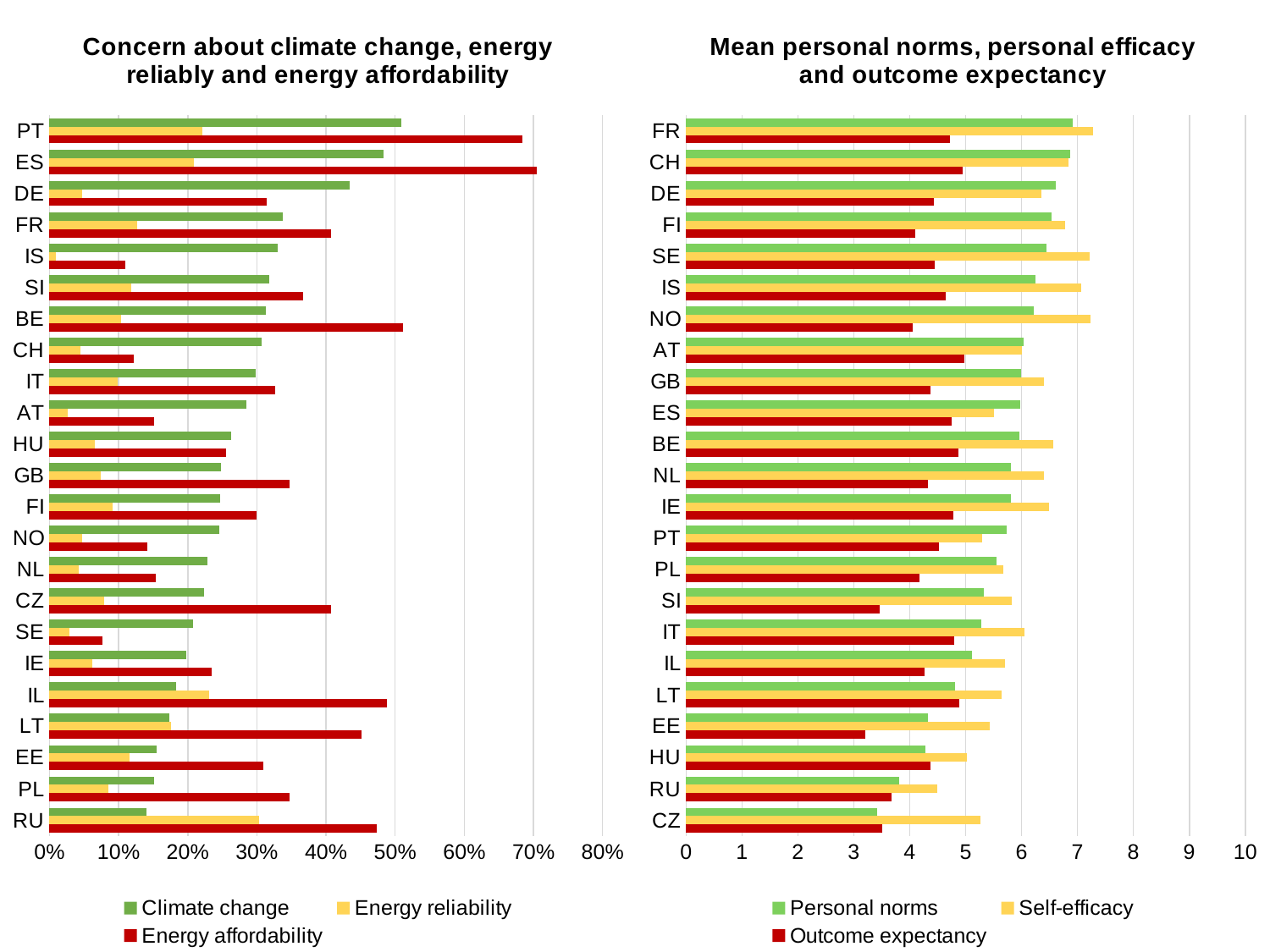
In the left chart, which country has the lowest Climate change value? RU In the left chart, is the Energy reliability value for IS greater or less than 10%? less In the right chart, for CZ, which is larger: Personal norms or Self-efficacy? Self-efficacy In the left chart, which country has the highest Energy reliability value? RU How many series does the legend of the right chart 'Mean personal norms, personal efficacy and outcome expectancy' list? 3 What type of chart is the left chart titled 'Concern about climate change, energy reliably and energy affordability'? bar chart In the left chart, which country has the highest Climate change value? PT In the right chart, is the Outcome expectancy value for EE greater or less than 4? less In the left chart, for PT, which is larger: Climate change or Energy affordability? Energy affordability In the right chart, which country has the lowest Personal norms value? CZ In the left chart, is the Energy affordability value for IL greater or less than 40%? greater How many countries are shown on the left chart 'Concern about climate change, energy reliably and energy affordability'? 23